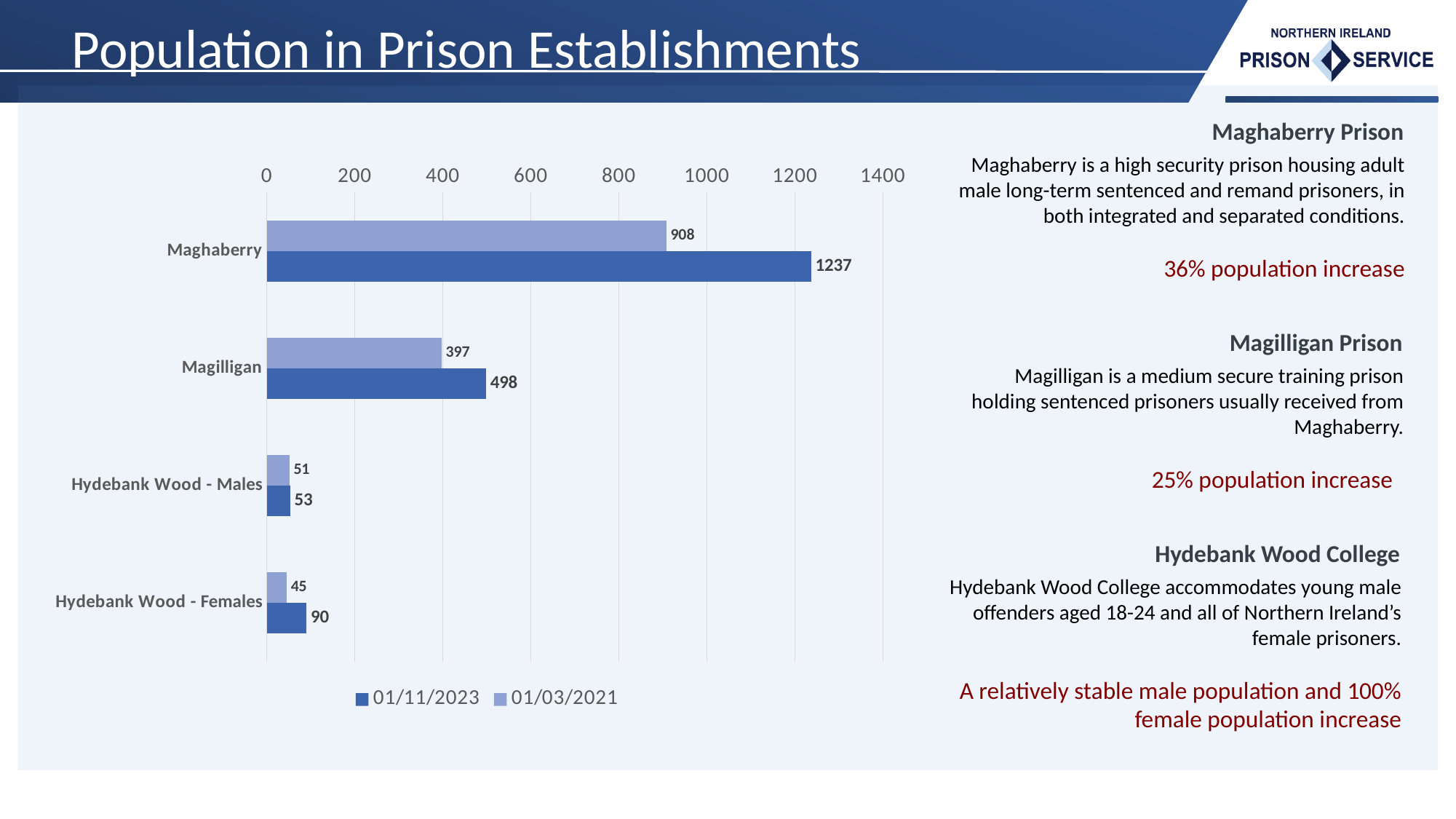
What was the population of Hydebank Wood - Females on 01/11/2023? 90 Is the Maghaberry population on 01/03/2021 greater or less than 1000? less What was the population of Maghaberry on 01/11/2023? 1237 Which establishment had the lowest population on 01/03/2021? Hydebank Wood - Females By how much did the Maghaberry population increase from 01/03/2021 to 01/11/2023? 329 Which is larger: the Hydebank Wood - Males population on 01/11/2023 or the Hydebank Wood - Females population on 01/11/2023? Hydebank Wood - Females How many establishments are shown on the chart? 4 Which establishment had the highest population on 01/11/2023? Maghaberry How many series does the legend list? 2 What kind of chart is shown on the slide? bar chart What was the population of Magilligan on 01/03/2021? 397 What is the difference between the Magilligan populations on 01/11/2023 and 01/03/2021? 101